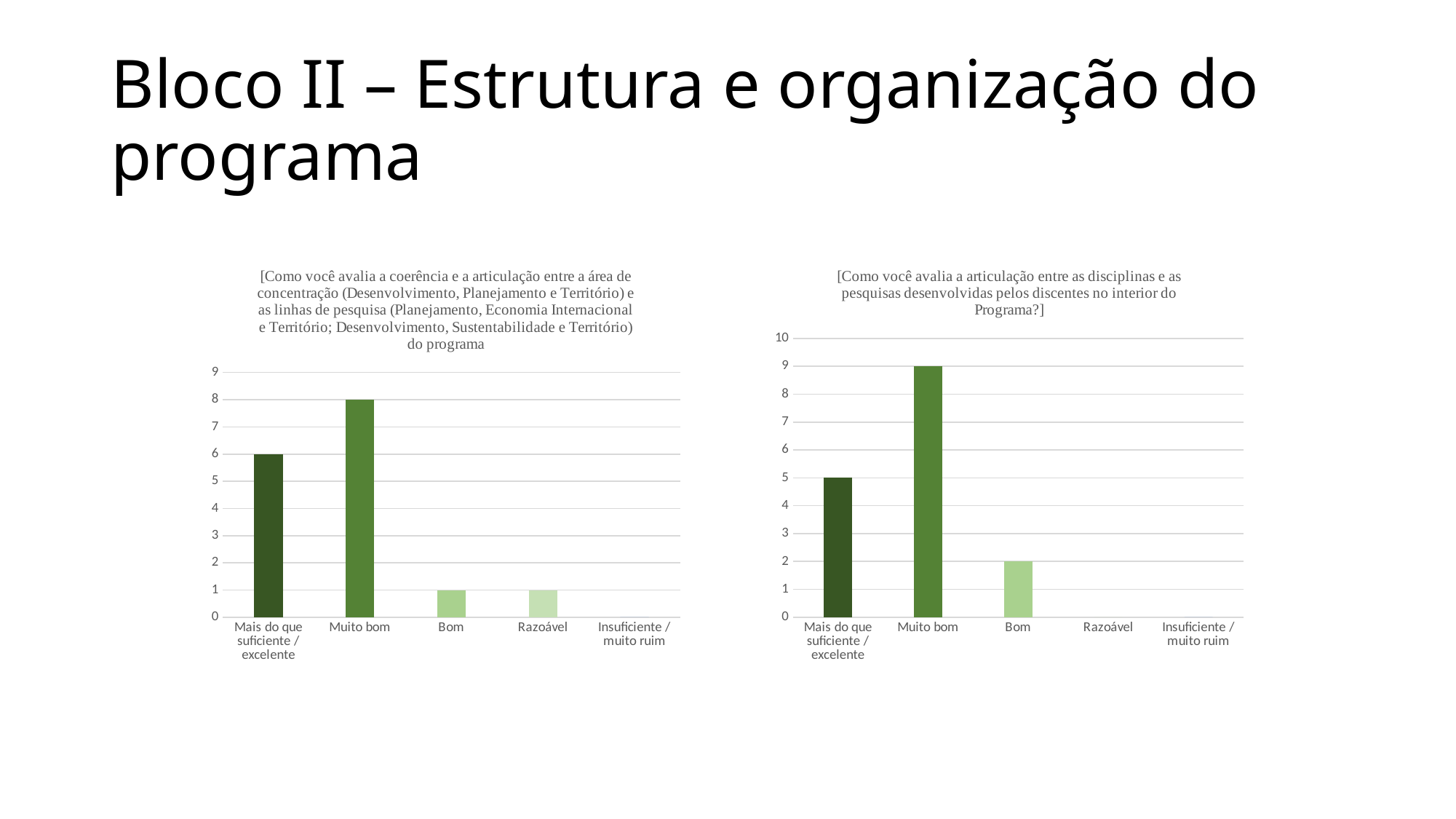
What kind of chart is the right chart? Bar chart In the left chart, what is the value for Mais do que suficiente / excelente? 6 In the left chart, which category has the highest value? Muito bom How many categories are shown on the x axis of the left chart? 5 In the left chart, what is the difference between Muito bom and Mais do que suficiente / excelente? 2 In the right chart, which is larger, Mais do que suficiente / excelente or Bom? Mais do que suficiente / excelente In the right chart, what is the value for Muito bom? 9 In the left chart, what is the value for Muito bom? 8 In the right chart, what is the value for Razoável? 0 In the right chart, what is the value for Bom? 2 In the right chart, which category has the highest value? Muito bom In the right chart, what is the difference between Muito bom and Mais do que suficiente / excelente? 4